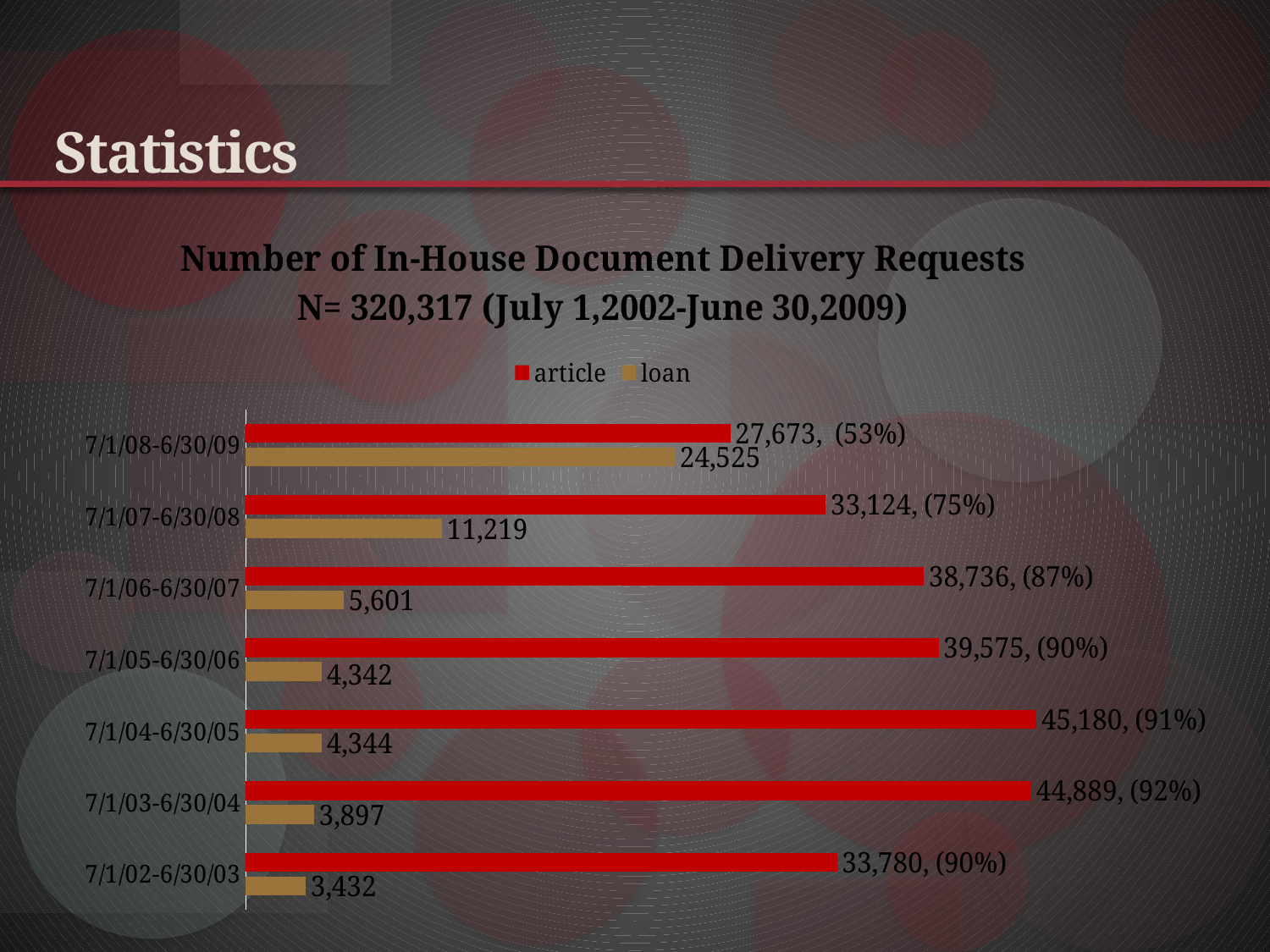
How many series does the legend list? 2 Which period has the highest number of loan requests? 7/1/08-6/30/09 Which period has the highest number of article requests? 7/1/04-6/30/05 Which is larger for 7/1/07-6/30/08, article requests or loan requests? article What is the number of loan requests for 7/1/07-6/30/08? 11,219 What is the combined number of article and loan requests for 7/1/07-6/30/08? 44,343 What kind of chart is shown on the slide? bar chart What is the number of article requests for 7/1/06-6/30/07? 38,736 How many time periods are shown on the chart? 7 What is the difference between article and loan requests for 7/1/08-6/30/09? 3,148 What percentage is shown next to the article bar for 7/1/08-6/30/09? 53% Which period has the lowest number of loan requests? 7/1/02-6/30/03